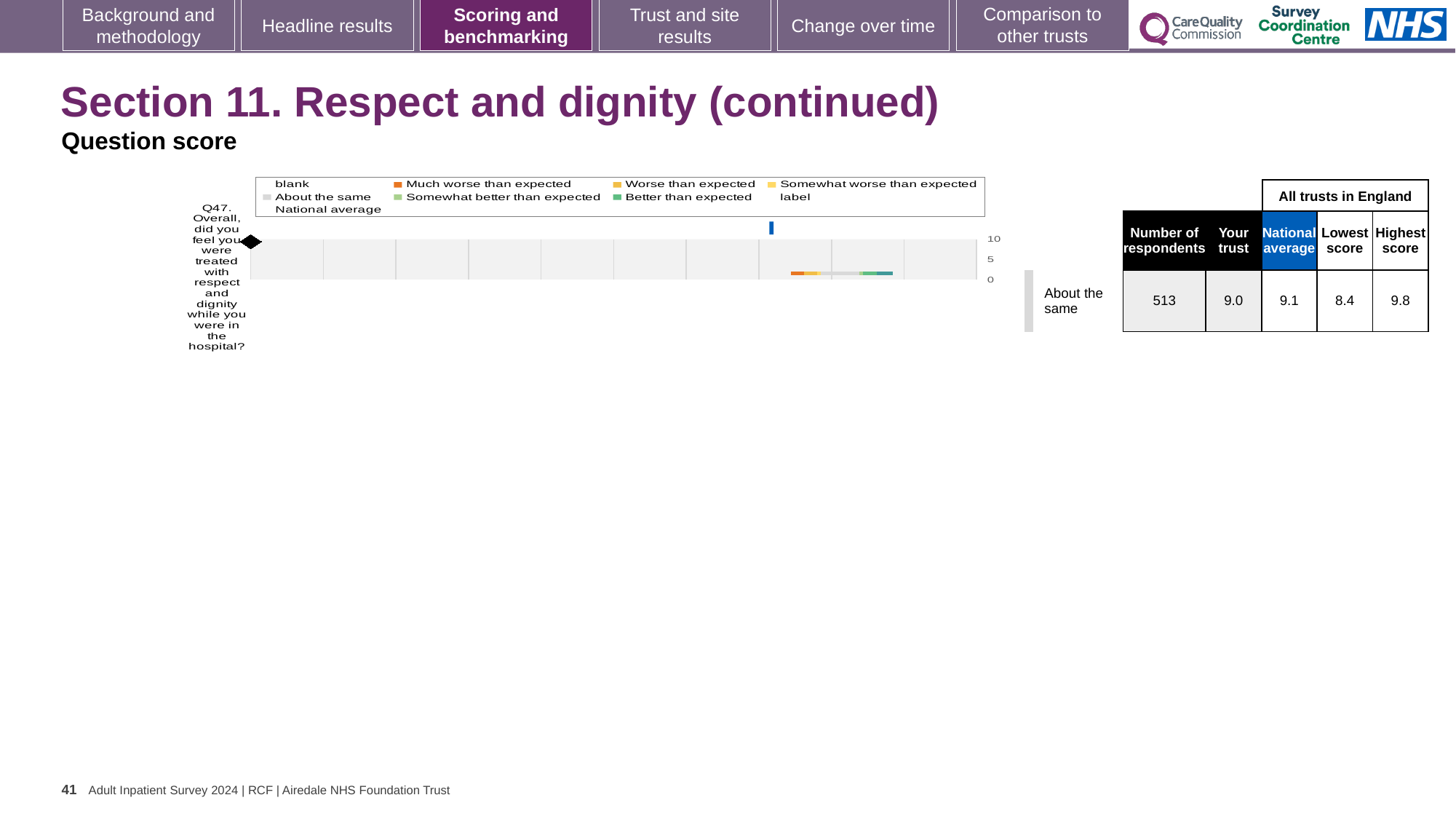
How many survey questions are plotted on the chart? 1 What is the national average score for Q47? 9.1 Which is larger for Q47, the 'Your trust' score or the national average? National average What is the 'Your trust' score for Q47? 9.0 What is the highest tick value shown on the chart's score axis? 10 How many respondents answered Q47? 513 What is the lowest score among all trusts in England for Q47? 8.4 Which survey question is plotted on the chart? Q47. Overall, did you feel you were treated with respect and dignity while you were in the hospital? What benchmarking category is the trust's result for Q47 placed in? About the same Is the 'Your trust' score for Q47 greater or less than 5? greater What is the highest score among all trusts in England for Q47? 9.8 What is the difference between the highest score and the lowest score for Q47? 1.4